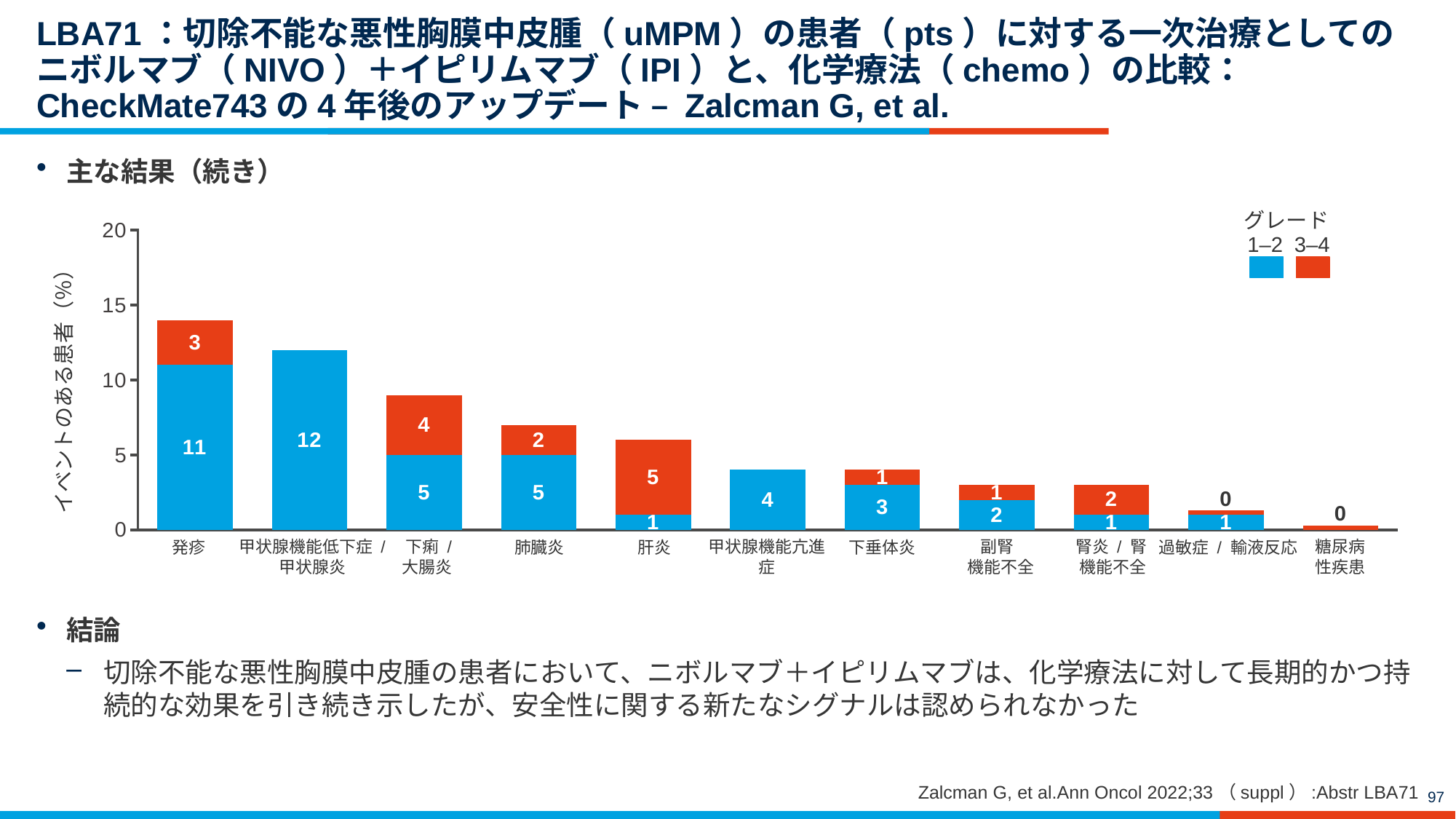
How many categories are shown on the x axis? 11 Which category has the highest grade 1–2 value? 甲状腺機能低下症 / 甲状腺炎 Which is larger, the grade 3–4 value for 下痢 / 大腸炎 or the grade 3–4 value for 肺臓炎? 下痢 / 大腸炎 What is the grade 1–2 value for 発疹? 11 What is the difference between the grade 1–2 values for 発疹 and 肺臓炎? 6 Which category has the highest grade 3–4 value? 肝炎 What is the grade 3–4 value for 肝炎? 5 How many series does the legend list? 2 What kind of chart is shown on the slide? Stacked bar chart What is the total height of the stacked bar for 発疹? 14 What is the grade 1–2 value for 甲状腺機能低下症 / 甲状腺炎? 12 What is the total height of the stacked bar for 下痢 / 大腸炎? 9